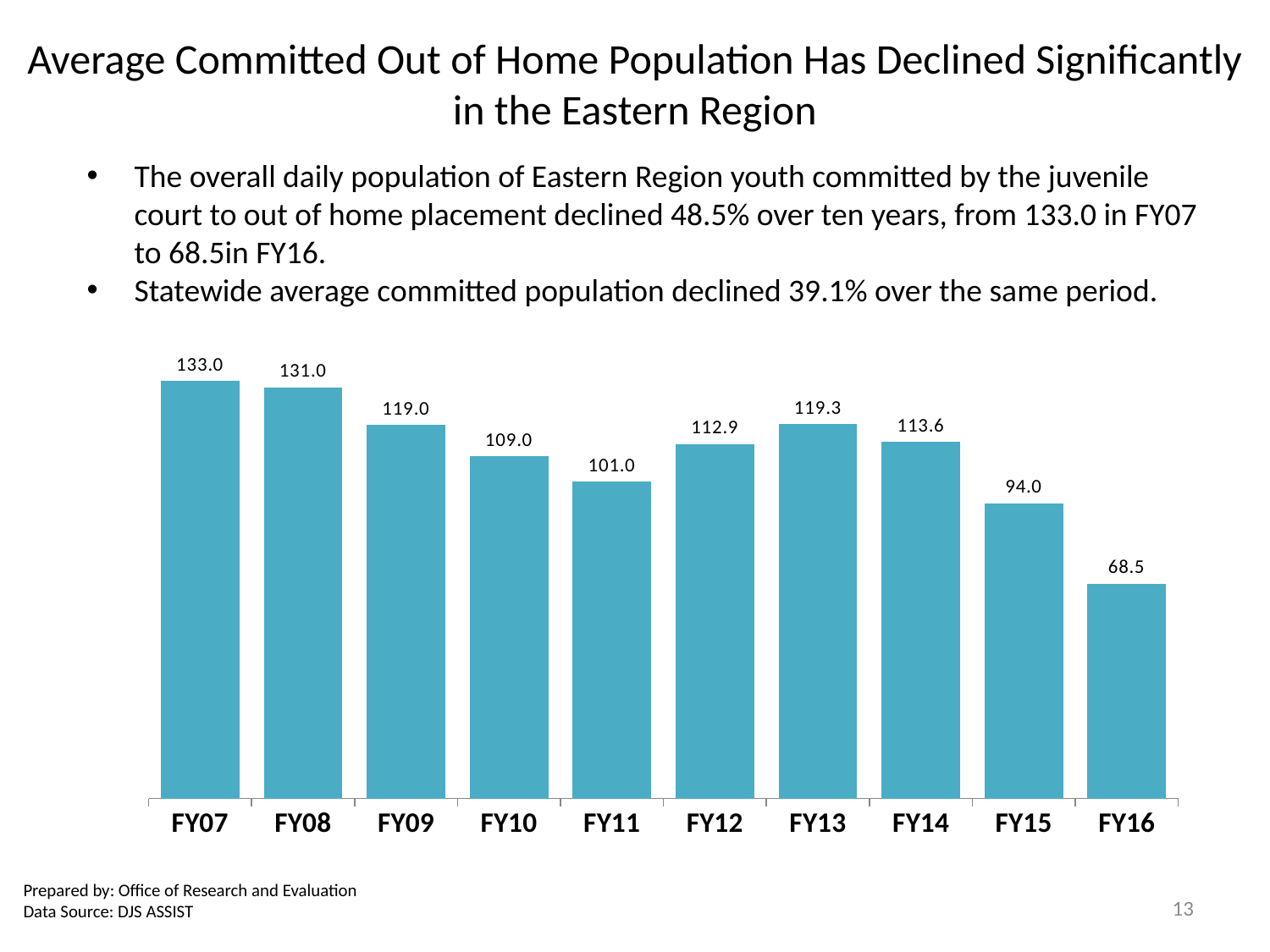
Which is larger, the value for FY12 or the value for FY14? FY14 What is the difference between the FY07 value and the FY16 value? 64.5 Which fiscal year has the lowest value? FY16 What is the value for FY11? 101.0 Which fiscal year has the highest value? FY07 What is the difference between the FY14 value and the FY15 value? 19.6 How many fiscal years are shown on the chart? 10 What is the value for FY16? 68.5 What is the value for FY13? 119.3 What kind of chart is shown on the slide? Bar chart What is the value for FY07? 133.0 Do the values generally rise or fall from FY07 to FY16? Fall